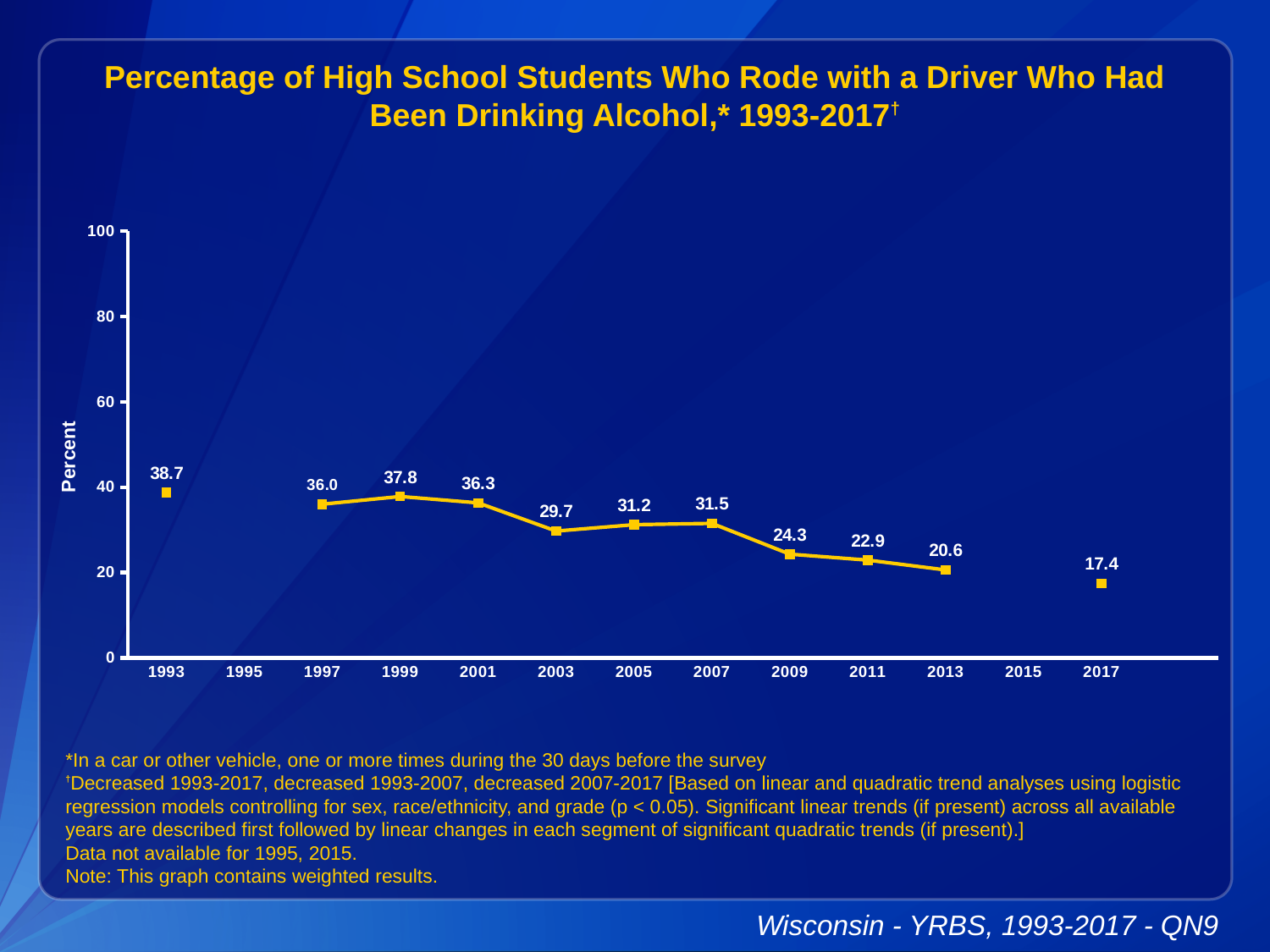
Which year has the lowest plotted value? 2017 Do the plotted values generally rise or fall from 1993 to 2017? Fall What is the difference between the values for 1993 and 2017? 21.3 How many data points are plotted on the chart? 11 What is the value plotted for 2017? 17.4 What is the label on the vertical axis of the chart? Percent Which year has the larger value, 1999 or 2001? 1999 What is the value plotted for 2007? 31.5 What kind of chart is shown on the slide? Line chart What percentage of high school students rode with a driver who had been drinking alcohol in 1993? 38.7 Which year has the highest plotted value? 1993 Is the value for 2009 greater or less than 20? greater